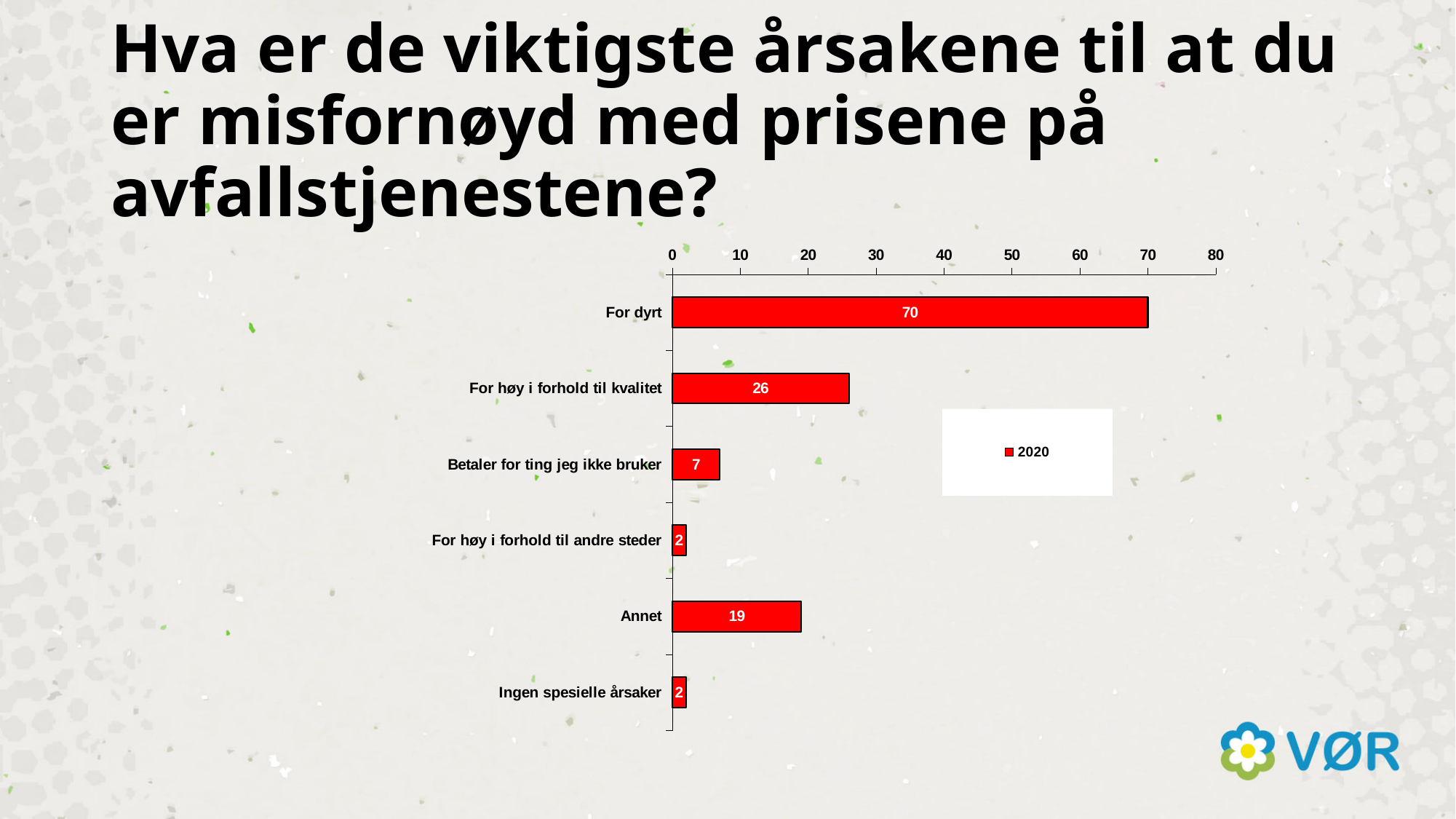
How many categories are shown in the chart? 6 How many series does the legend list? 1 What series name is shown in the legend? 2020 Is the value for "For høy i forhold til kvalitet" greater or less than 20? greater What is the difference between the values for "For dyrt" and "For høy i forhold til kvalitet"? 44 What kind of chart is shown on the slide? Bar chart What is the value for "Betaler for ting jeg ikke bruker"? 7 What is the value for "Annet"? 19 What is the value for "For høy i forhold til kvalitet"? 26 Which category has the highest value? For dyrt What is the value for "For dyrt"? 70 Which is larger, the value for "Annet" or the value for "Betaler for ting jeg ikke bruker"? Annet